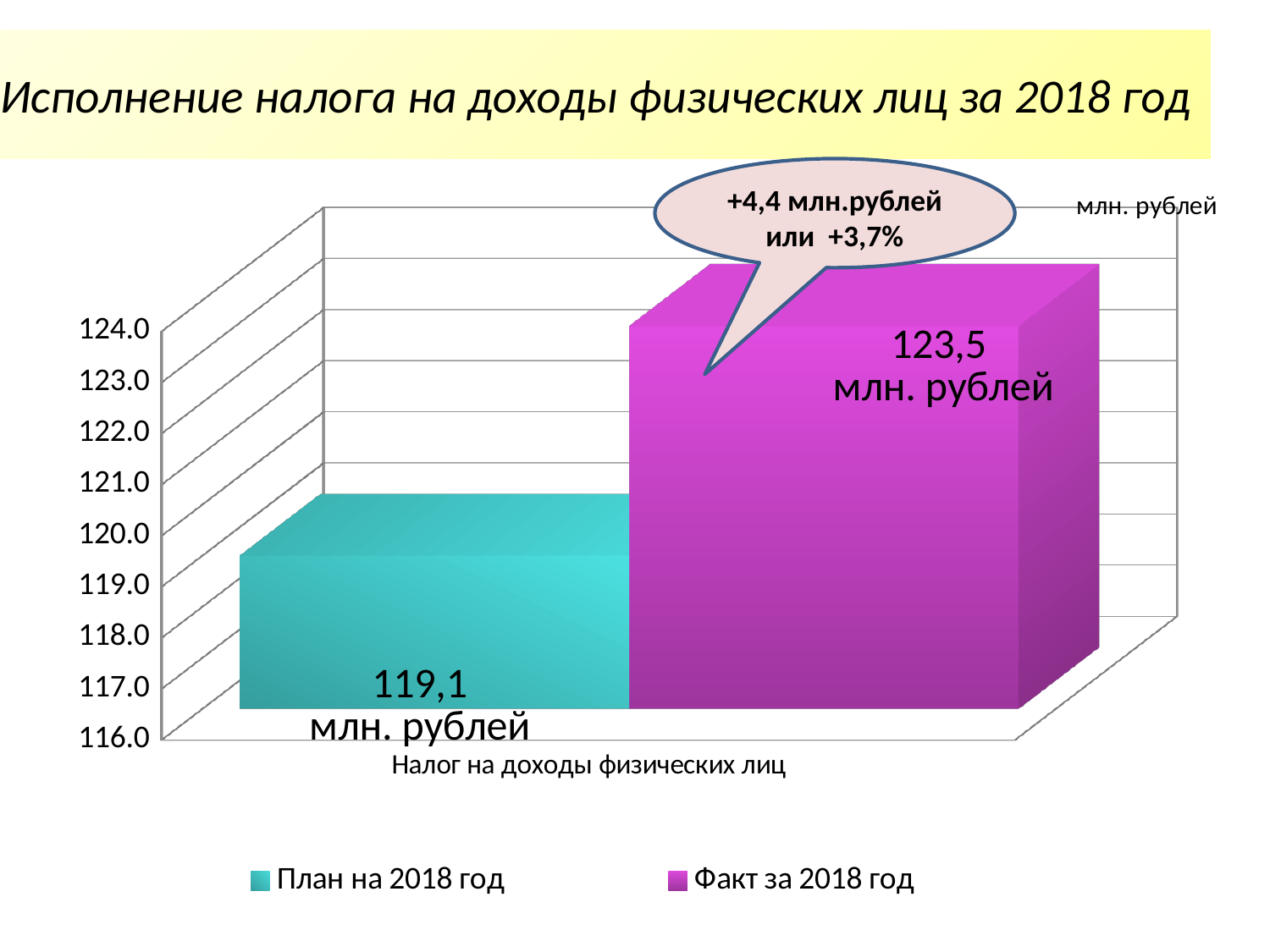
What is the value for "План на 2018 год"? 119,1 млн. рублей Is the value for "Факт за 2018 год" greater or less than 123.0? greater Is the value for "План на 2018 год" greater or less than 120.0? less What is the difference between the "Факт за 2018 год" value and the "План на 2018 год" value? 4,4 млн. рублей How many series does the legend list? 2 What kind of chart is shown on the slide? bar chart What is the category label shown on the x axis? Налог на доходы физических лиц What percentage increase does the callout on the chart state? +3,7% Which series has the lowest value? План на 2018 год How many categories are shown on the x axis? 1 What is the value for "Факт за 2018 год"? 123,5 млн. рублей Which series has the higher value, "План на 2018 год" or "Факт за 2018 год"? Факт за 2018 год